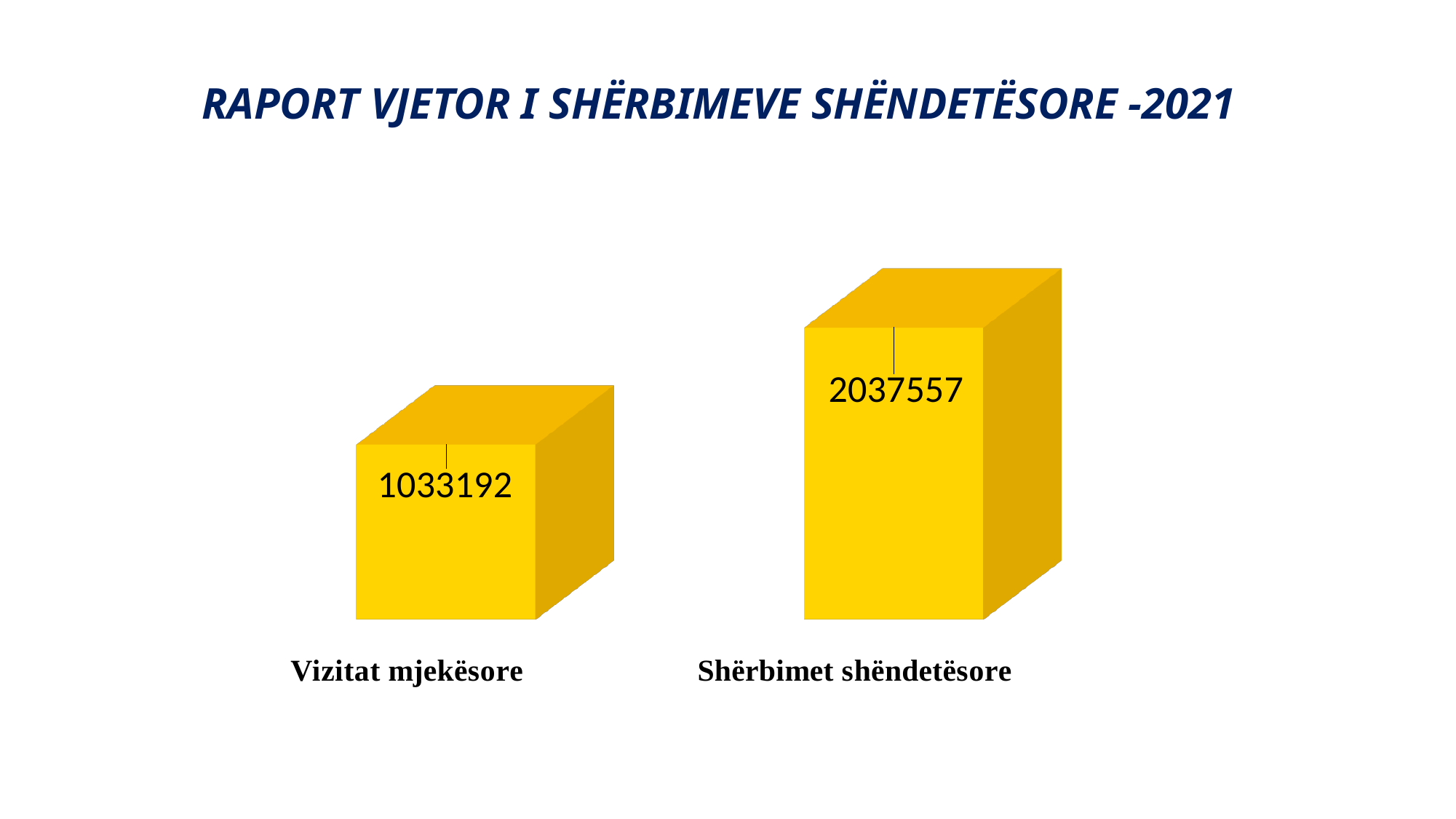
Which category has the lowest value? Vizitat mjekësore Which category has the highest value? Shërbimet shëndetësore How many categories are shown in the chart? 2 What is the difference between the values for Shërbimet shëndetësore and Vizitat mjekësore? 1004365 What is the value for Vizitat mjekësore? 1033192 What is the total of the two values shown in the chart? 3070749 What kind of chart is shown on the slide? Bar chart What is the title of the slide? RAPORT VJETOR I SHËRBIMEVE SHËNDETËSORE -2021 Which is larger, the value for Vizitat mjekësore or the value for Shërbimet shëndetësore? Shërbimet shëndetësore What is the value for Shërbimet shëndetësore? 2037557 What colour are the bars in the chart? Yellow